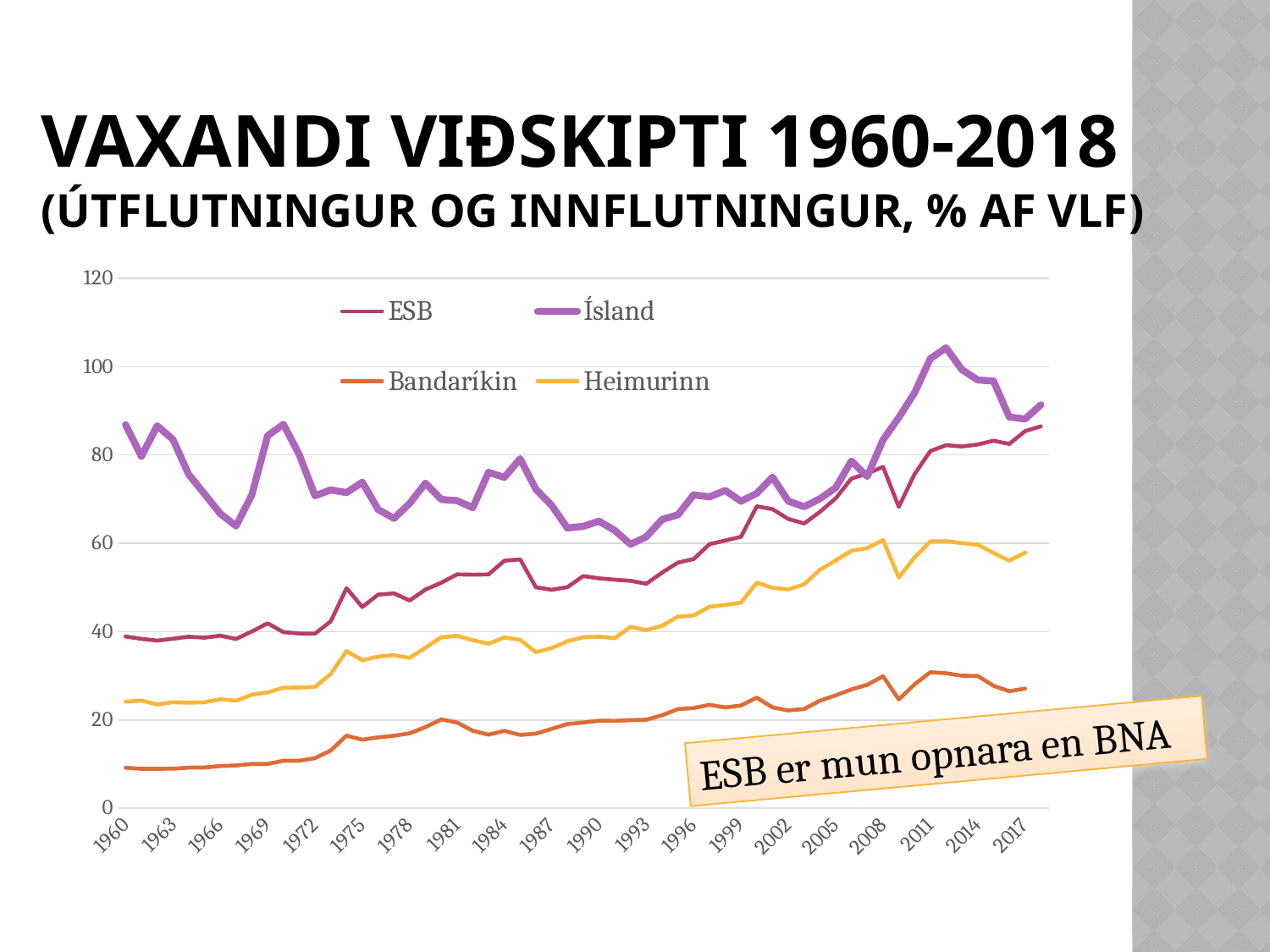
Which series is drawn in yellow? Heimurinn Does the Bandaríkin series generally rise or fall from 1960 to 2017? rise In 2017, which is larger, the value for ESB or the value for Heimurinn? ESB Is the value for Heimurinn in 1960 greater or less than 40? less How many series does the legend list? 4 Is the value for Bandaríkin in 1960 greater or less than 20? less Which series has the highest value in 1960? Ísland What does the annotation box on the chart say? ESB er mun opnara en BNA Is the value for ESB in 2017 greater or less than 80? greater What kind of chart is shown on the slide? line chart Which series has the lowest value in 2017? Bandaríkin